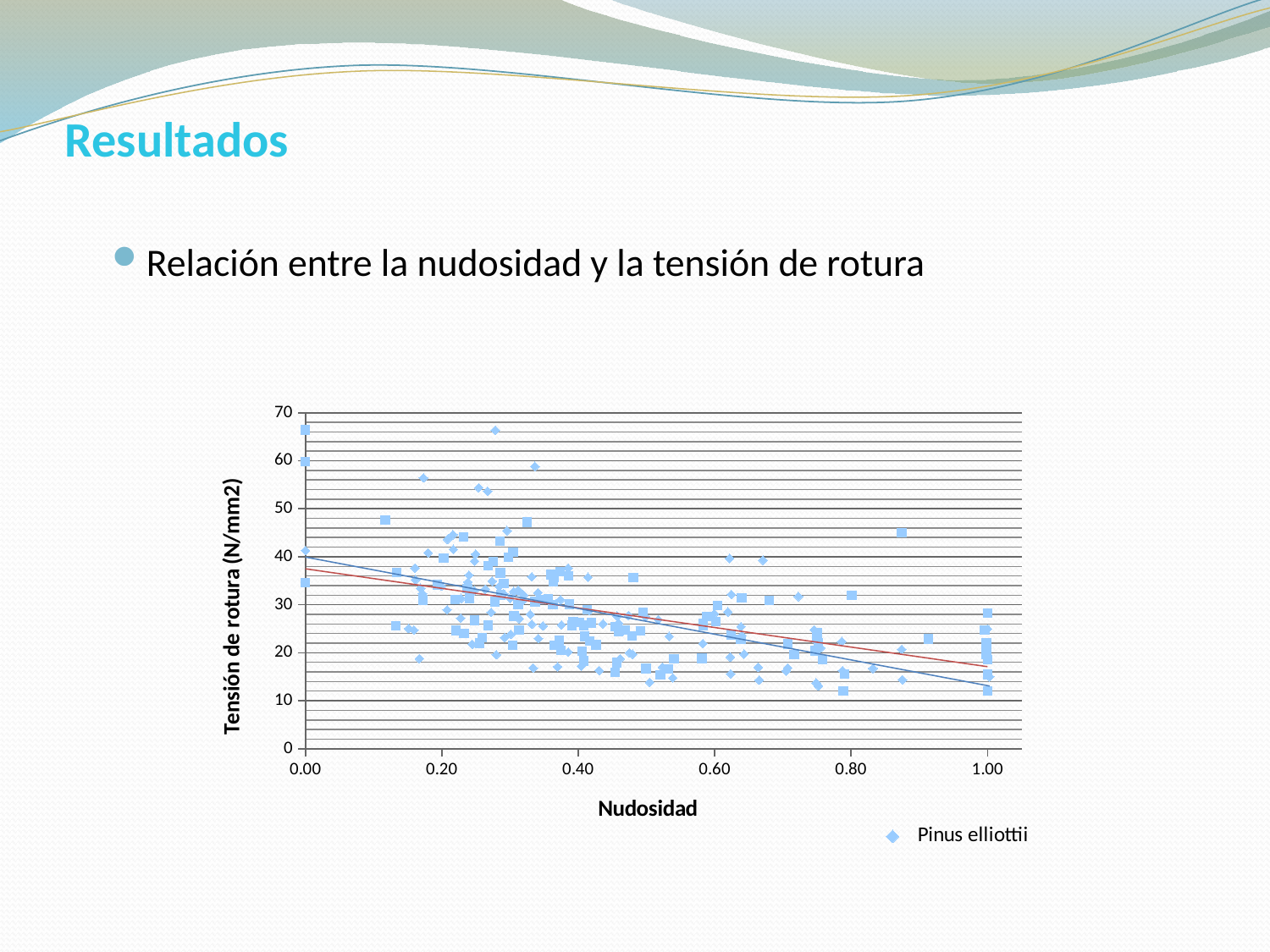
What is the name of the series shown in the legend? Pinus elliottii What is the maximum value shown on the x axis? 1.00 Is the lowest plotted tensión de rotura value greater or less than 20? less As Nudosidad increases along the x axis, do the tensión de rotura values generally rise or fall? fall What is the title of the y axis? Tensión de rotura (N/mm2) What is the maximum value shown on the y axis? 70 What kind of chart is shown on the slide? scatter chart How many series does the legend list? 1